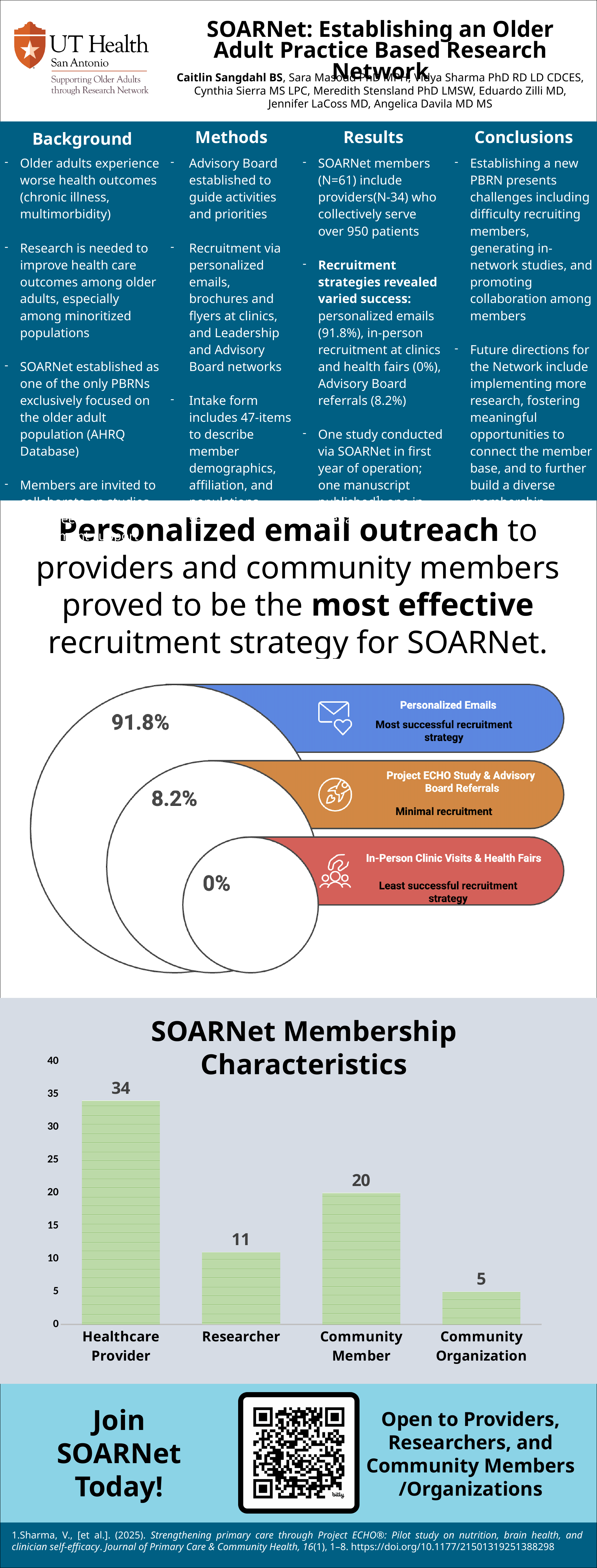
In the SOARNet Membership Characteristics chart, what is the value for Community Member? 20 In the SOARNet Membership Characteristics chart, which category has the lowest value? Community Organization In the SOARNet Membership Characteristics chart, what is the value for Community Organization? 5 In the SOARNet Membership Characteristics chart, what is the difference between the Healthcare Provider and Community Member values? 14 In the SOARNet Membership Characteristics chart, which is larger: Researcher or Community Member? Community Member How many categories are shown in the SOARNet Membership Characteristics chart? 4 In the SOARNet Membership Characteristics chart, which category has the highest value? Healthcare Provider In the SOARNet Membership Characteristics chart, what is the value for Researcher? 11 What is the title of the bar chart at the bottom of the slide? SOARNet Membership Characteristics What kind of chart is the SOARNet Membership Characteristics chart? bar chart In the SOARNet Membership Characteristics chart, is the value for Researcher greater or less than 15? less In the SOARNet Membership Characteristics chart, what is the value for Healthcare Provider? 34